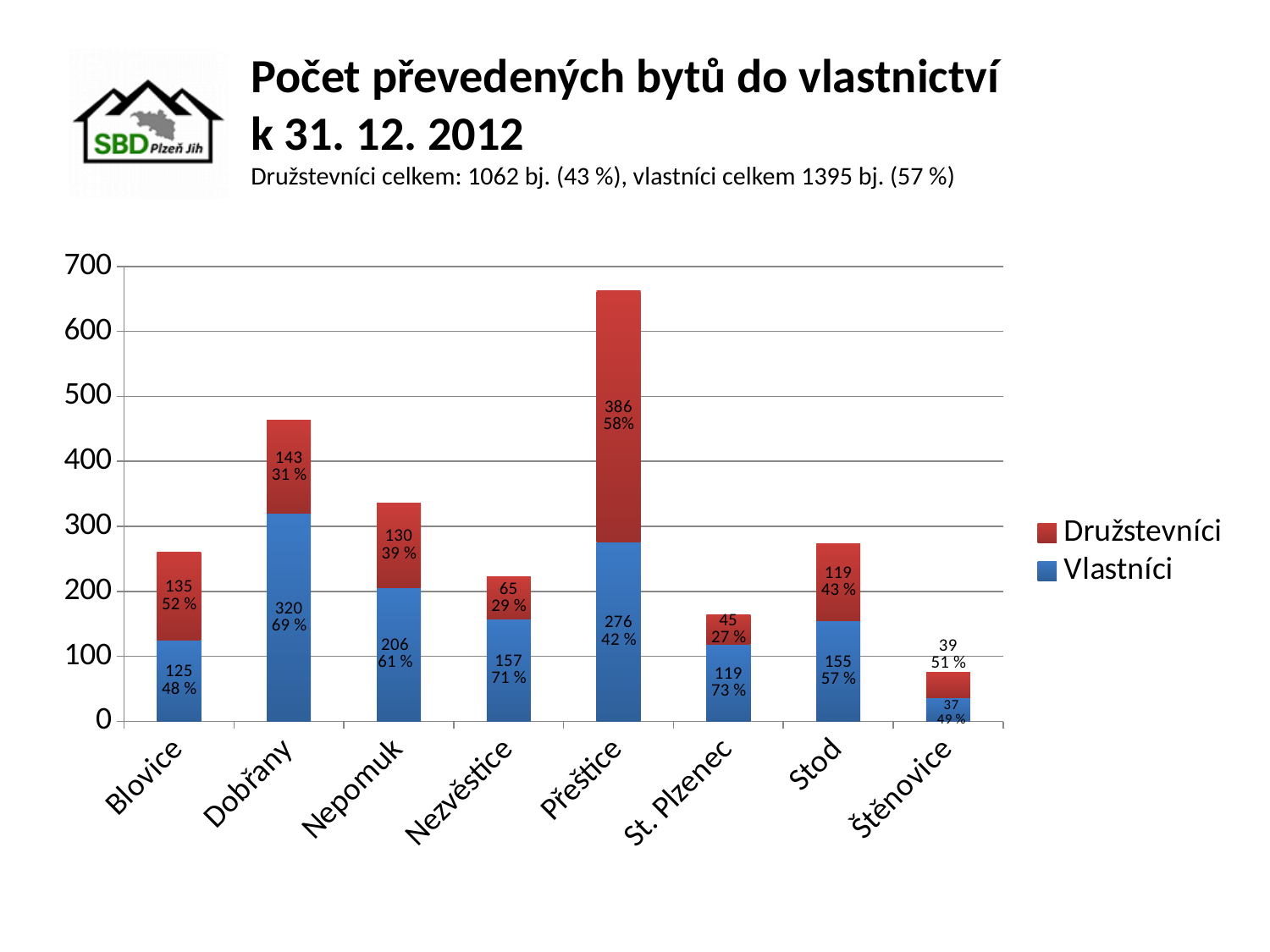
Which is larger for Stod: the Vlastníci value or the Družstevníci value? Vlastníci Which locality has the lowest Vlastníci value? Štěnovice What is the total number of units (Vlastníci plus Družstevníci) for Blovice? 260 What is the Vlastníci value for Dobřany? 320 Which locality has the highest Družstevníci value? Přeštice How many series does the legend list? 2 What type of chart is shown on the slide? Stacked bar chart How many categories (localities) are shown on the x axis? 8 What is the Družstevníci value for Přeštice? 386 Is the total stacked bar for Přeštice greater or less than 600? greater What is the difference between the Vlastníci values for Dobřany and Nepomuk? 114 What percentage is shown for Vlastníci in St. Plzenec? 73 %